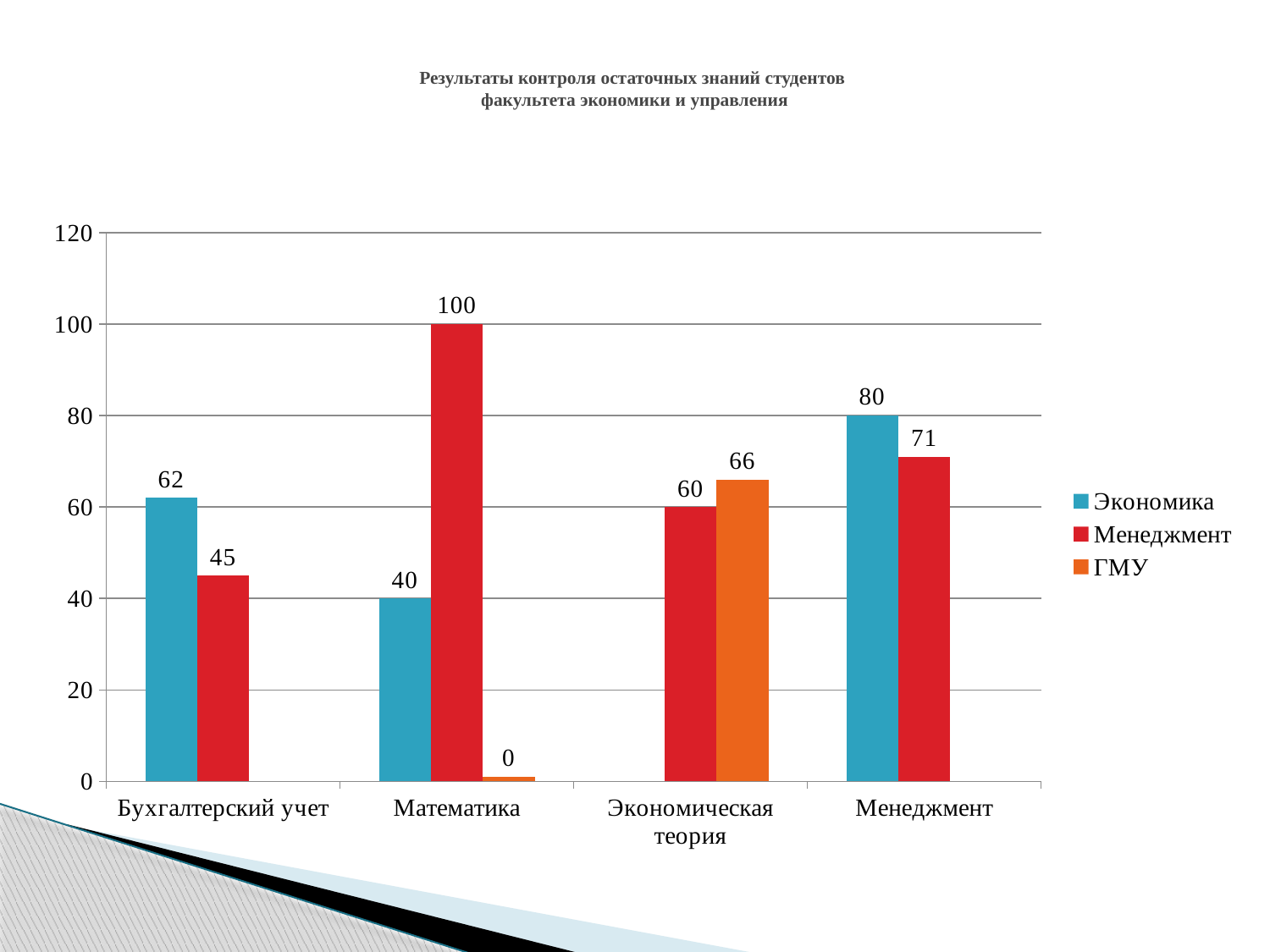
What is the value for Менеджмент in the Менеджмент category? 71 Which category has the lowest value for the Менеджмент series? Бухгалтерский учет How many categories are shown on the x axis? 4 Which category has the highest value for the Экономика series? Менеджмент How many series does the legend list? 3 What is the value for ГМУ in the Экономическая теория category? 66 What is the value for Менеджмент in the Математика category? 100 What kind of chart is shown on the slide? Bar chart Which series is shown in orange in the legend? ГМУ What is the difference between the Экономика and Менеджмент values in the Бухгалтерский учет category? 17 What is the value for Экономика in the Бухгалтерский учет category? 62 In the Экономическая теория category, which is larger: Менеджмент or ГМУ? ГМУ